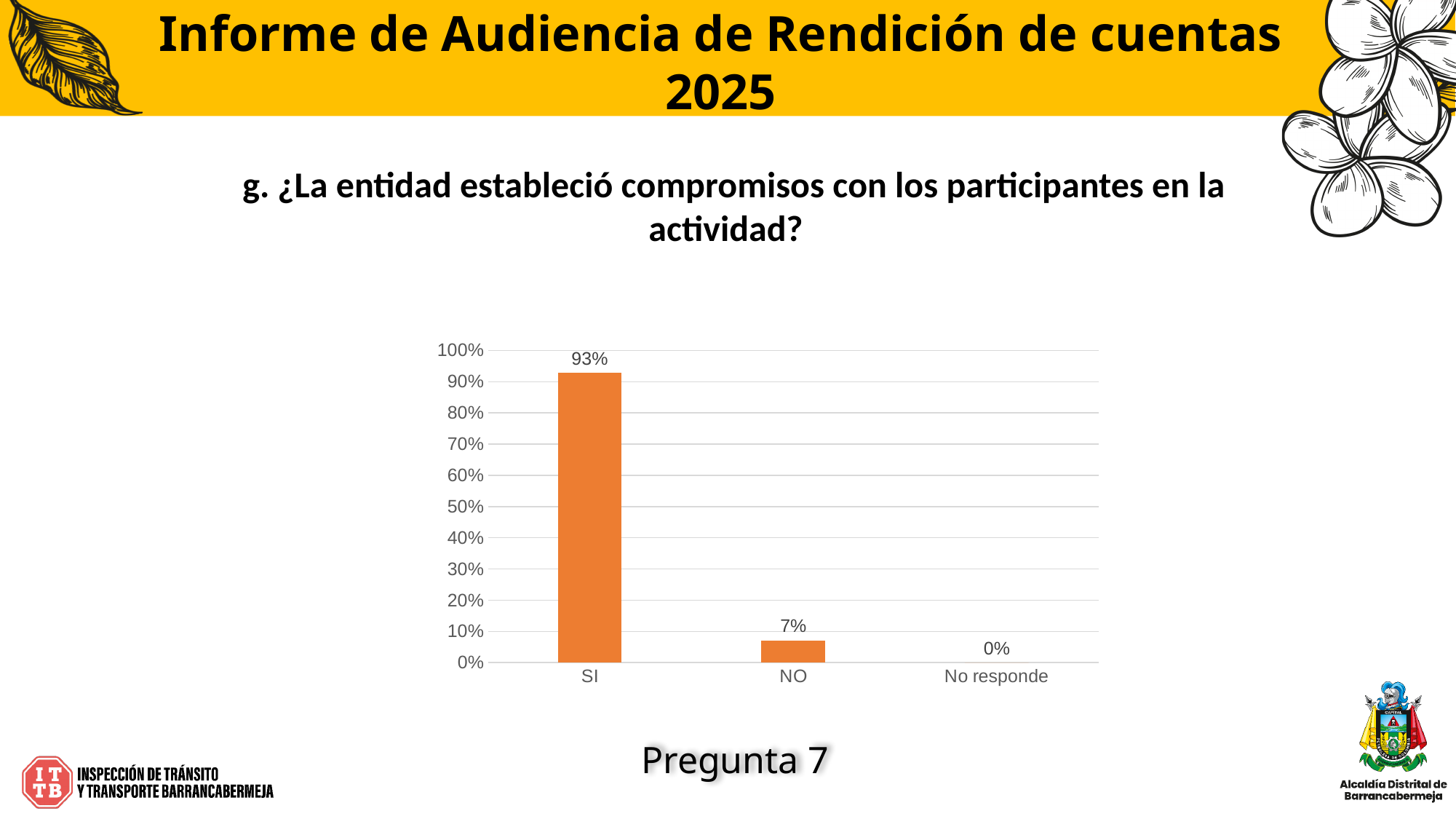
What is the value for No responde? 0% Is the value for NO greater or less than 10%? less What kind of chart is shown on the slide? bar chart What is the difference between the values for SI and NO? 86% Which category has the lowest value? No responde Is the value for SI greater or less than 50%? greater What is the label shown below the chart? Pregunta 7 How many categories are shown on the x axis? 3 Which is larger, the value for SI or the value for NO? SI Which category has the highest value? SI What is the value for SI? 93% What is the value for NO? 7%